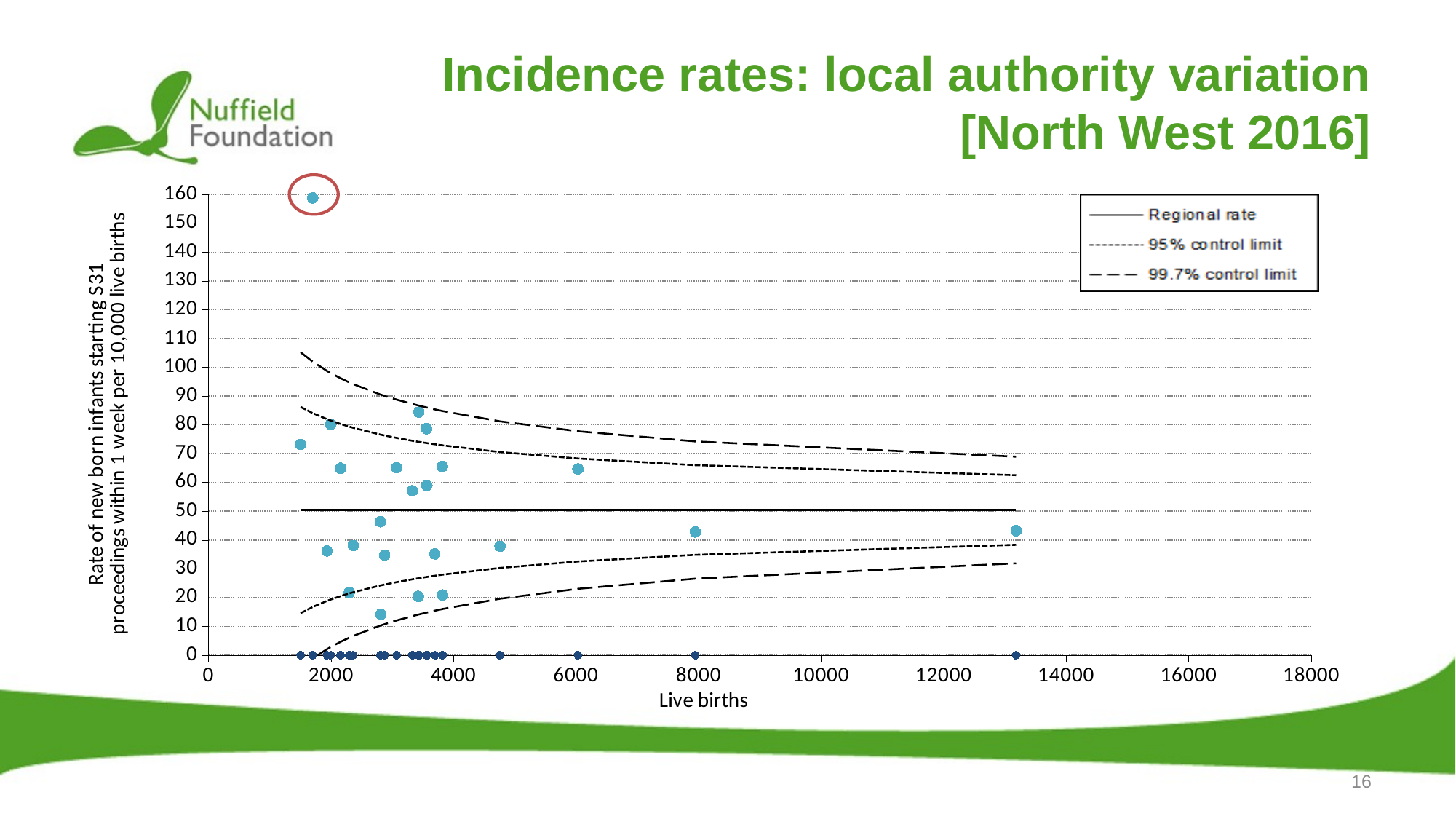
Does the lower 95% control limit line rise or fall as live births increase along the x axis? rise Is the value of the point plotted at about 6,000 live births greater or less than 50? greater At what y-axis value does the solid Regional rate line sit? 50 What is the title of the chart's x axis? Live births What is the highest value shown on the y axis? 160 Is the value of the point plotted at about 13,000 live births greater or less than 50? less Which legend entry is drawn as a solid line? Regional rate Is the value of the circled point at the top of the chart greater or less than 140? greater What kind of chart is shown on the slide? scatter plot How many entries does the chart legend list? 3 Does the upper 99.7% control limit line rise or fall as live births increase along the x axis? fall